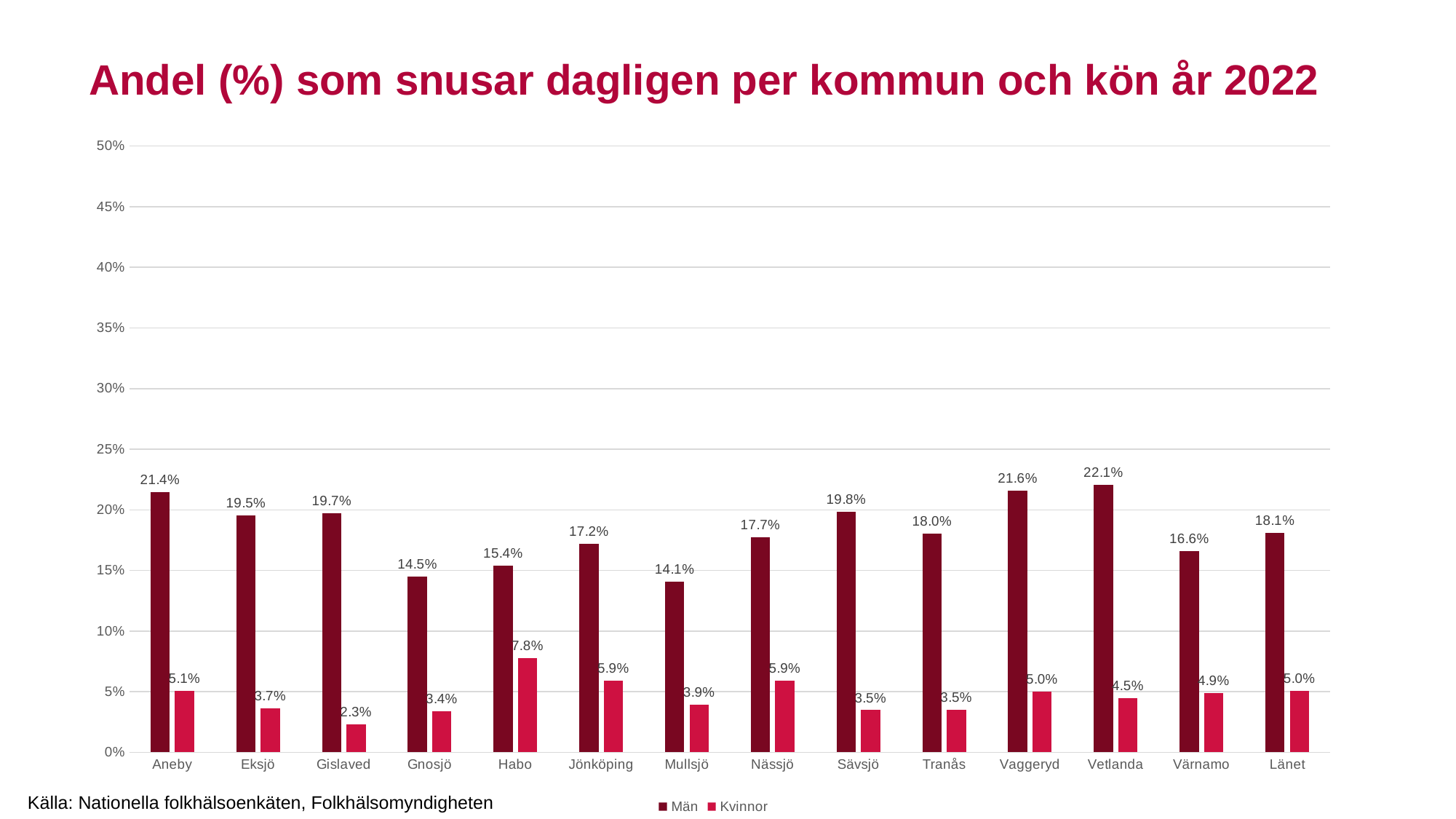
What is the value for Män in Vetlanda? 22.1% Which municipality has the lowest value for Kvinnor? Gislaved What kind of chart is shown on the slide? Bar chart How many municipalities/categories are shown on the x axis? 14 What is the value for Män in Länet? 18.1% What is the value for Kvinnor in Habo? 7.8% Is the value for Män in Gnosjö greater or less than 15%? less What is the difference between the Män and Kvinnor values in Aneby? 16.3% Which municipality has the highest value for Män? Vetlanda Which municipality has the lowest value for Män? Mullsjö How many series does the legend list? 2 Which is larger: the Kvinnor value for Jönköping or for Eksjö? Jönköping